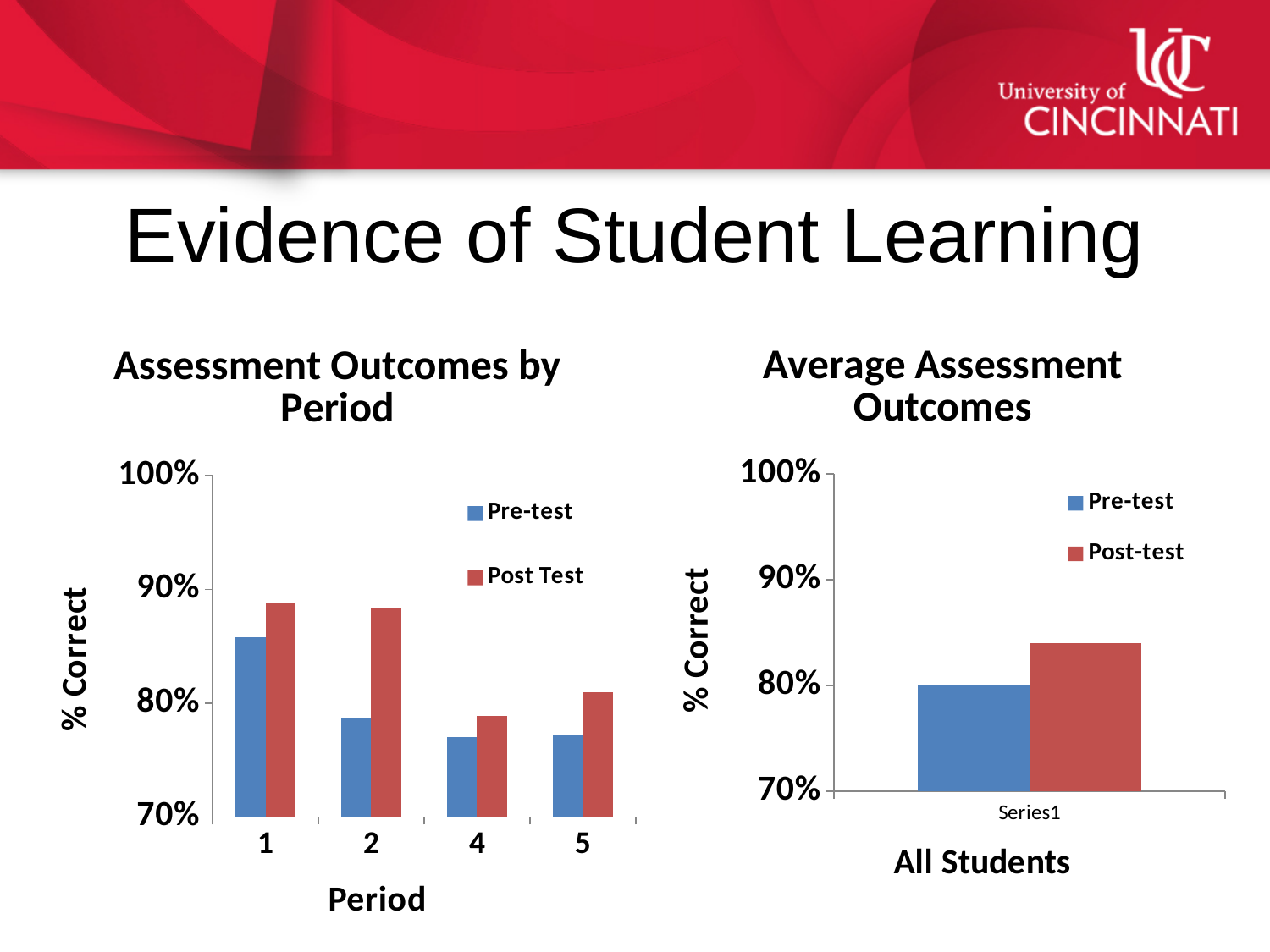
In the "Average Assessment Outcomes" chart, which is larger: Pre-test or Post-test? Post-test What kind of chart is the "Average Assessment Outcomes" chart? bar chart In the "Average Assessment Outcomes" chart, is the Post-test value greater or less than 80%? greater In the "Assessment Outcomes by Period" chart, how many periods are shown on the x axis? 4 In the "Assessment Outcomes by Period" chart, is the Pre-test value for period 1 greater or less than 80%? greater In the "Assessment Outcomes by Period" chart, which period has the lowest Post Test value? 4 What kind of chart is the "Assessment Outcomes by Period" chart? bar chart In the "Assessment Outcomes by Period" chart, how many series does the legend list? 2 In the "Assessment Outcomes by Period" chart, is the Post Test value for period 4 greater or less than 80%? less In the "Average Assessment Outcomes" chart, how many series does the legend list? 2 In the "Assessment Outcomes by Period" chart, for period 2, which is larger: Pre-test or Post Test? Post Test In the "Assessment Outcomes by Period" chart, which period has the highest Pre-test value? 1